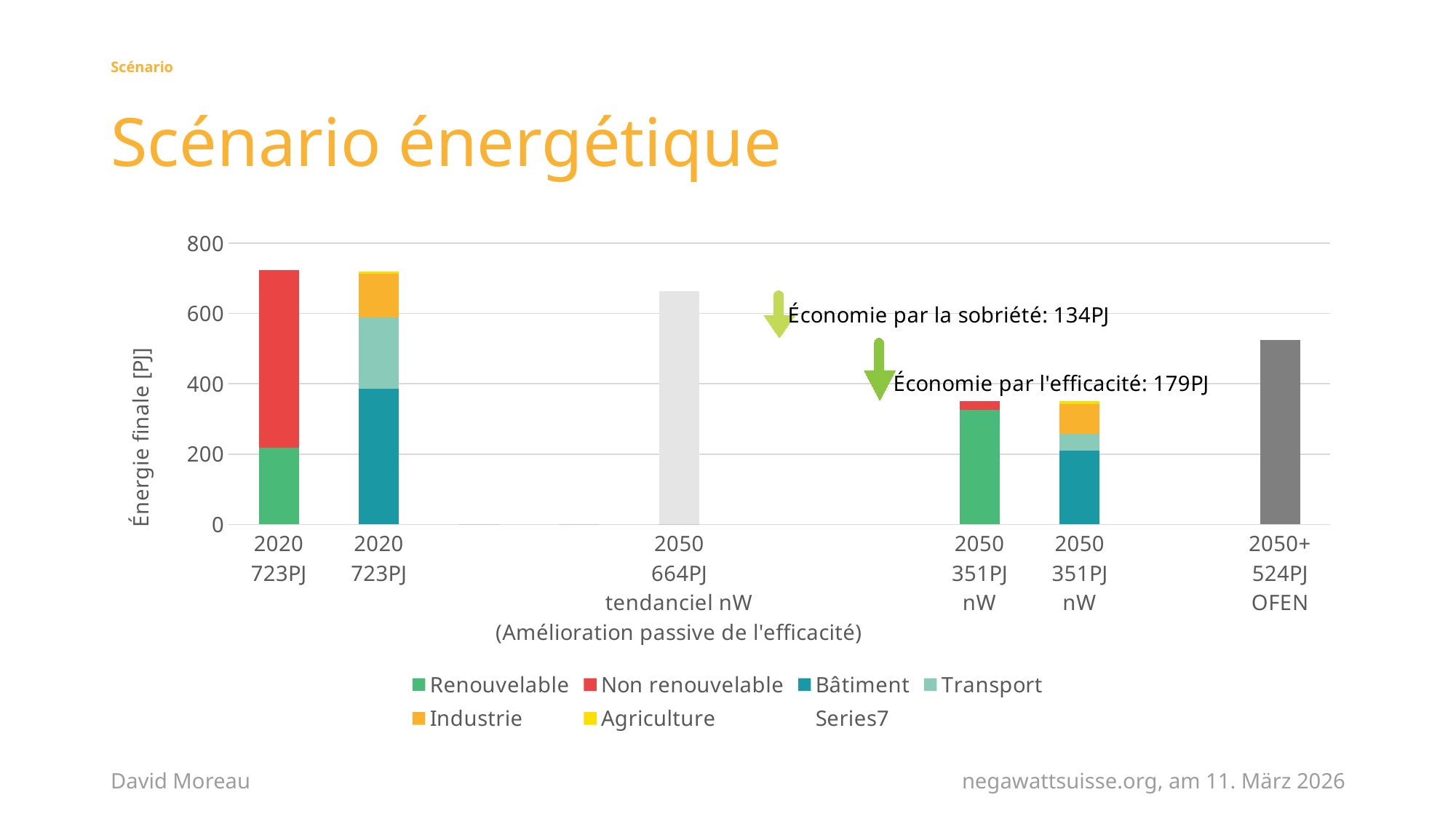
What is the y-axis title of the chart? Énergie finale [PJ] What is the difference between the 2050 tendanciel nW total (664PJ) and the 2050 nW total (351PJ)? 313PJ What is the total final energy for the '2050 tendanciel nW' bar? 664PJ Which is larger, the 2050+ OFEN total or the 2050 nW total? 2050+ OFEN What is the total final energy for the '2050+ OFEN' bar? 524PJ Which scenario has the lowest total final energy? 2050 nW (351PJ) What kind of chart is shown on the slide? Stacked bar chart How many series does the legend list? 7 What is the difference between the 2020 total (723PJ) and the 2050 tendanciel nW total (664PJ)? 59PJ Is the value of the 2050+ OFEN bar greater or less than 600? less What is the total final energy for the 2020 bars? 723PJ How many labelled bars are shown on the x axis? 6